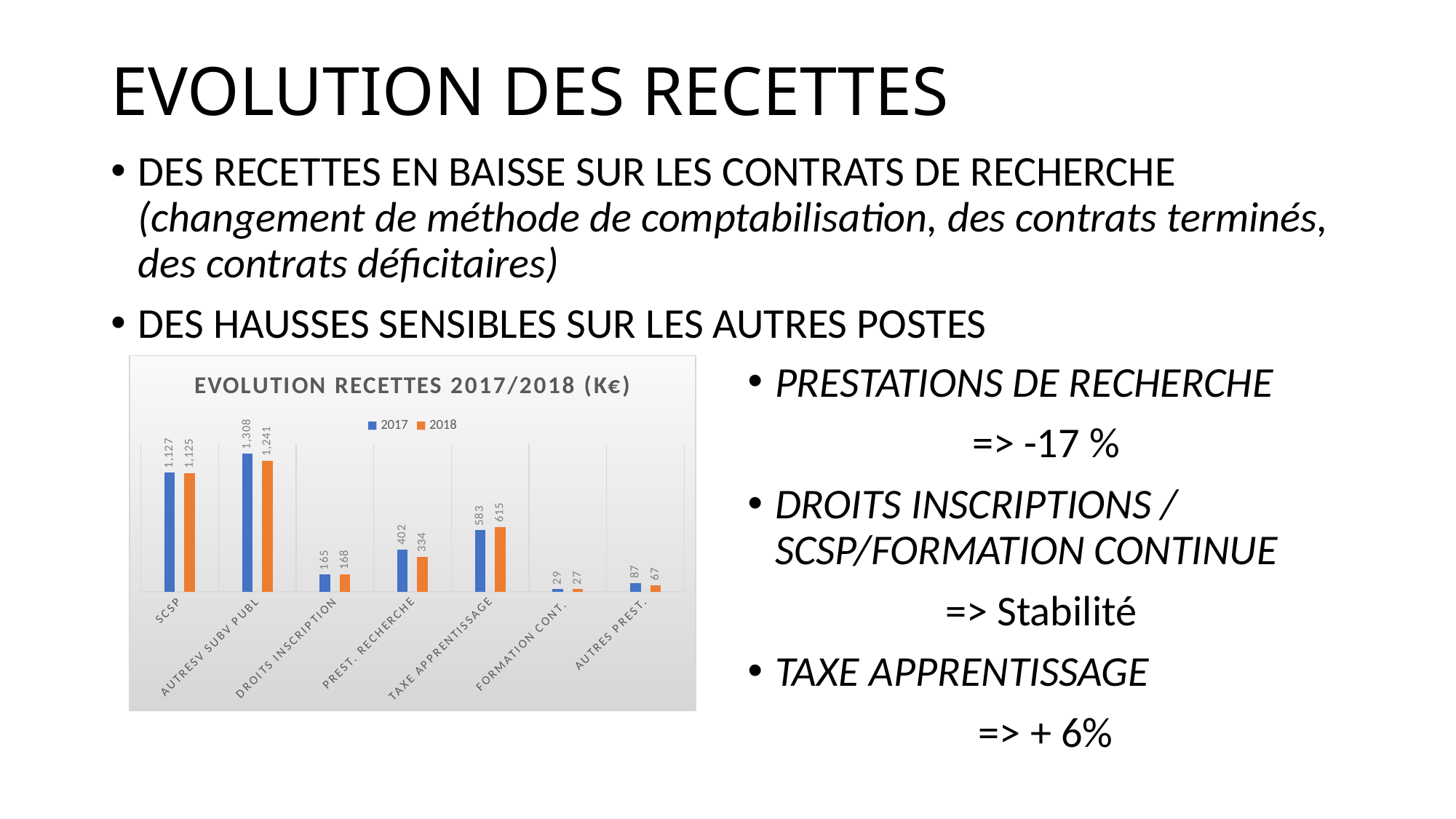
What is the 2017 value for SCSP? 1,127 What is the difference between the 2017 and 2018 values for AUTRESV SUBV PUBL? 67 How many series does the chart legend list? 2 What is the 2018 value for TAXE APPRENTISSAGE? 615 What is the 2018 value for PREST. RECHERCHE? 334 What is the difference between the 2017 and 2018 values for PREST. RECHERCHE? 68 For TAXE APPRENTISSAGE, which year has the larger value, 2017 or 2018? 2018 Which category has the lowest 2018 value? FORMATION CONT. What type of chart is shown on the slide? Bar chart How many categories are shown on the x axis of the chart? 7 Which category has the highest 2017 value? AUTRESV SUBV PUBL What is the 2017 value for FORMATION CONT.? 29